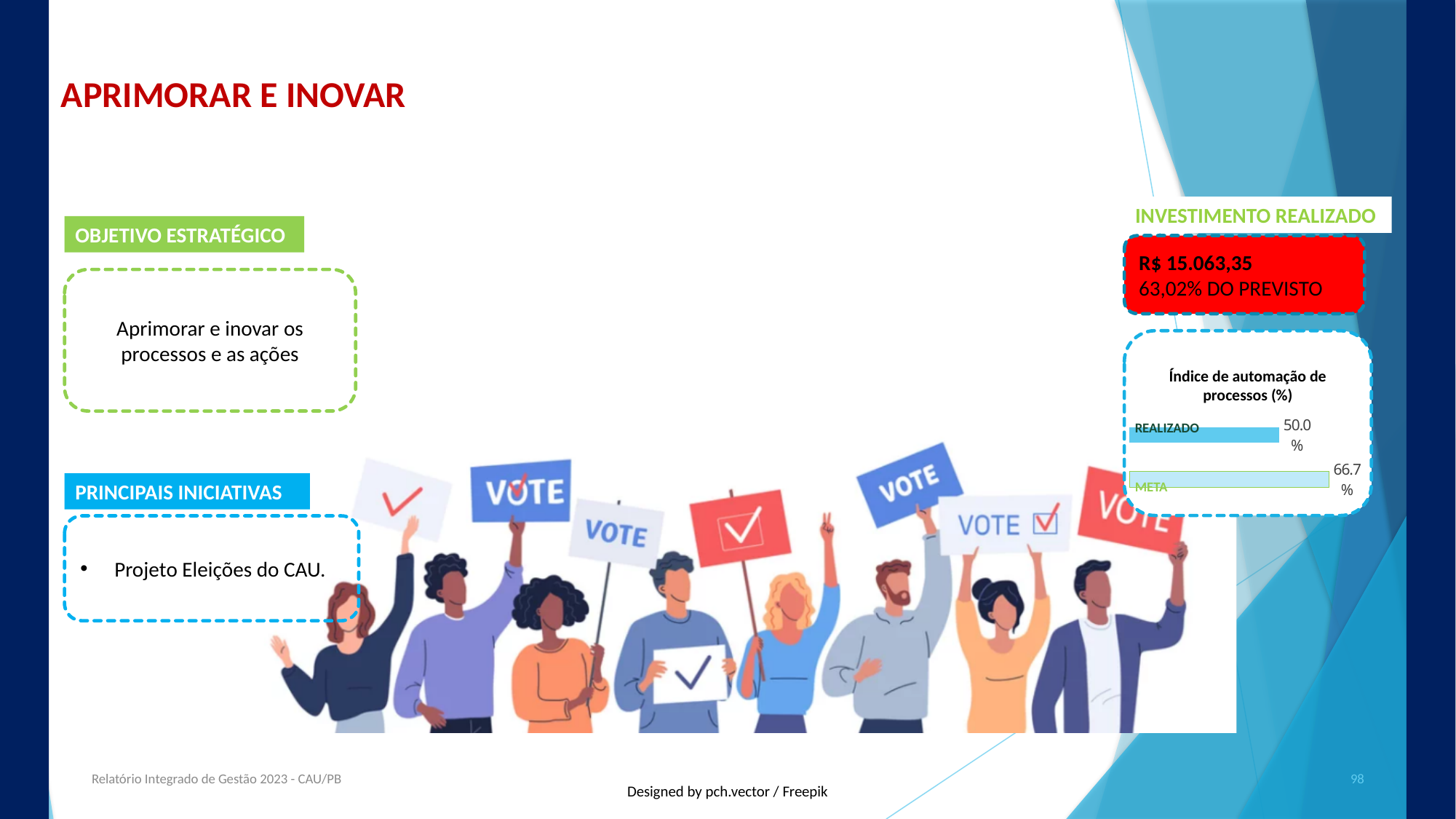
Is the value for REALIZADO greater or less than the value for META? less Which category has the higher value in the chart, REALIZADO or META? META What is the title of the chart on the slide? Índice de automação de processos (%) What kind of chart is shown under "Índice de automação de processos (%)"? bar chart Which category has the highest value in the chart? META What is the difference between the META value and the REALIZADO value in the chart? 16.7% How many bars are plotted in the chart? 2 What is the value for META in the chart? 66.7% What is the value for REALIZADO in the chart? 50.0% Which category has the lowest value in the chart? REALIZADO